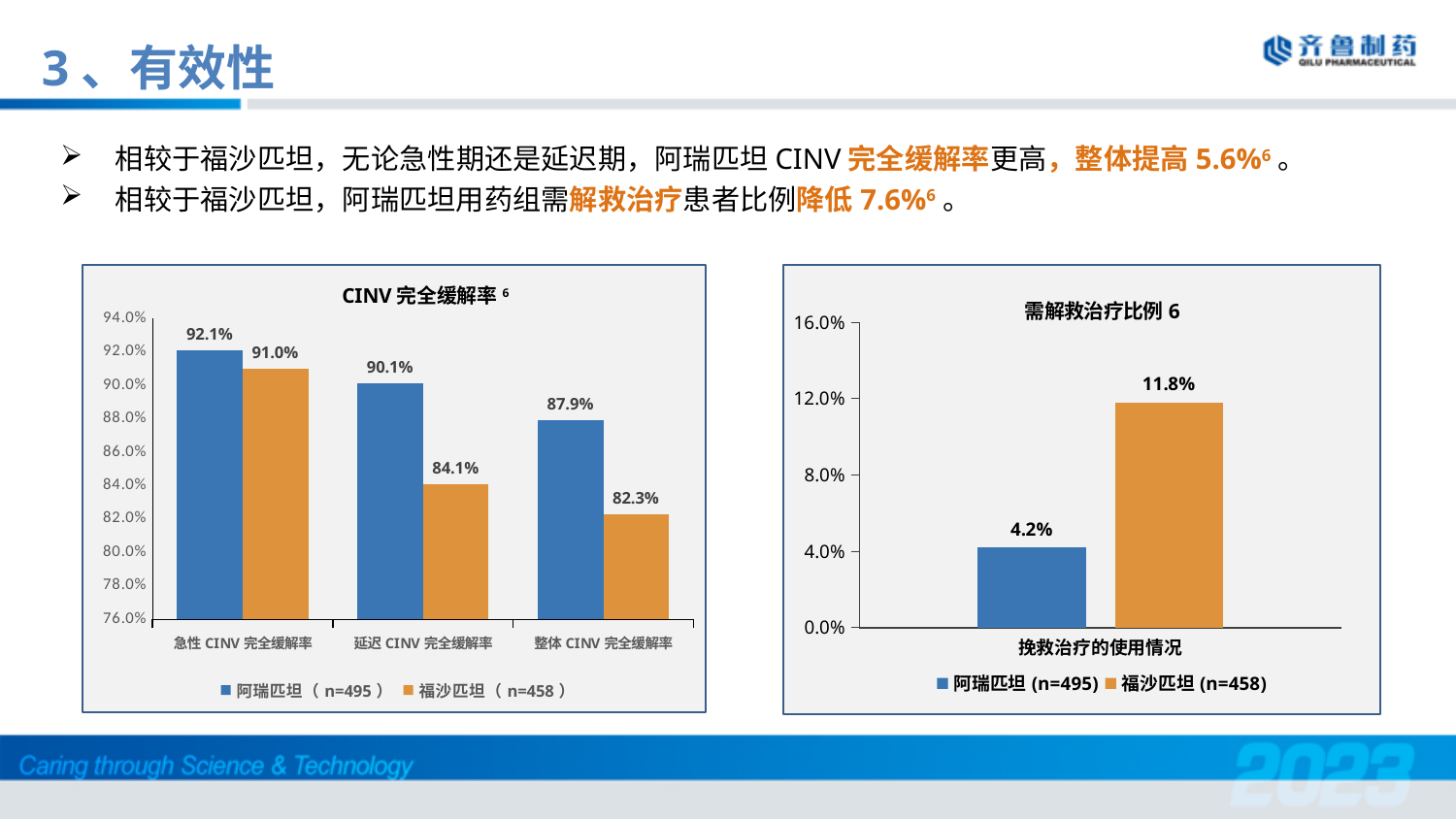
In the right chart (需解救治疗比例), what is the difference between the 福沙匹坦 and 阿瑞匹坦 values? 7.6% In the left chart (CINV 完全缓解率), how many categories are shown on the x axis? 3 In the left chart (CINV 完全缓解率), what is the value for 福沙匹坦 in the 延迟 CINV 完全缓解率 category? 84.1% In the left chart (CINV 完全缓解率), what is the value for 福沙匹坦 in the 整体 CINV 完全缓解率 category? 82.3% In the left chart (CINV 完全缓解率), what is the difference between 阿瑞匹坦 and 福沙匹坦 in the 延迟 CINV 完全缓解率 category? 6.0% In the left chart (CINV 完全缓解率), what is the value for 阿瑞匹坦 in the 急性 CINV 完全缓解率 category? 92.1% In the left chart (CINV 完全缓解率), does the value for 福沙匹坦 trend upward or downward across the categories from left to right? downward In the right chart (需解救治疗比例), how many series does the legend list? 2 In the left chart (CINV 完全缓解率), which category has the lowest value for 阿瑞匹坦? 整体 CINV 完全缓解率 In the right chart (需解救治疗比例), what is the value for 福沙匹坦? 11.8% What type of chart is the right chart (需解救治疗比例)? bar chart In the left chart (CINV 完全缓解率), which series has the larger value in the 整体 CINV 完全缓解率 category? 阿瑞匹坦